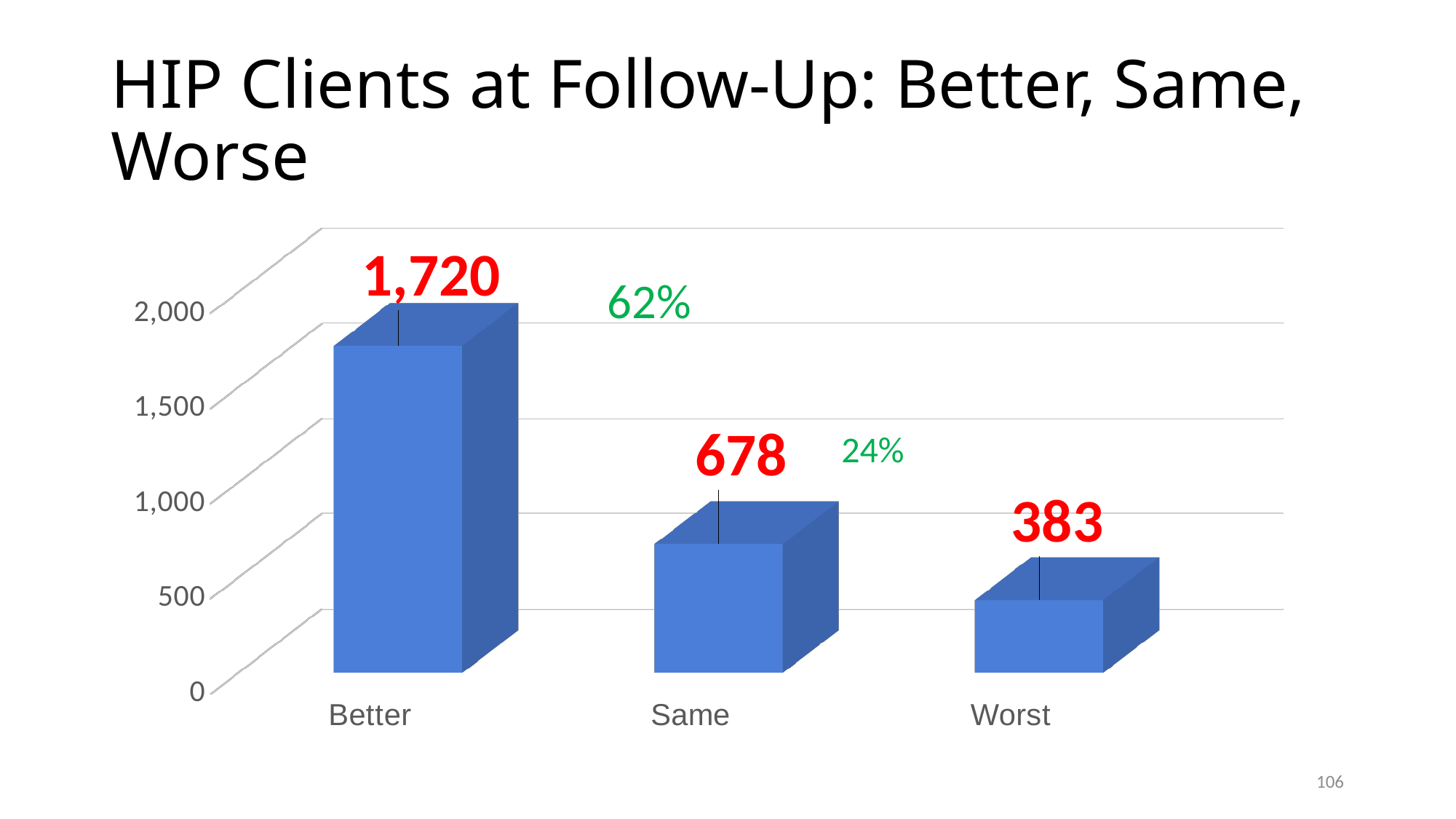
Which is larger, the value for Same or the value for Worst? Same Which category has the lowest value? Worst Is the value for Better greater or less than 1,500? greater What is the value for Better? 1,720 What is the difference between the values for Same and Worst? 295 Which category has the highest value? Better What percentage is shown in green next to the Same bar? 24% How many categories are shown on the x axis? 3 What is the difference between the values for Better and Same? 1,042 What kind of chart is shown on the slide? bar chart What is the value for Same? 678 What is the value for Worst? 383